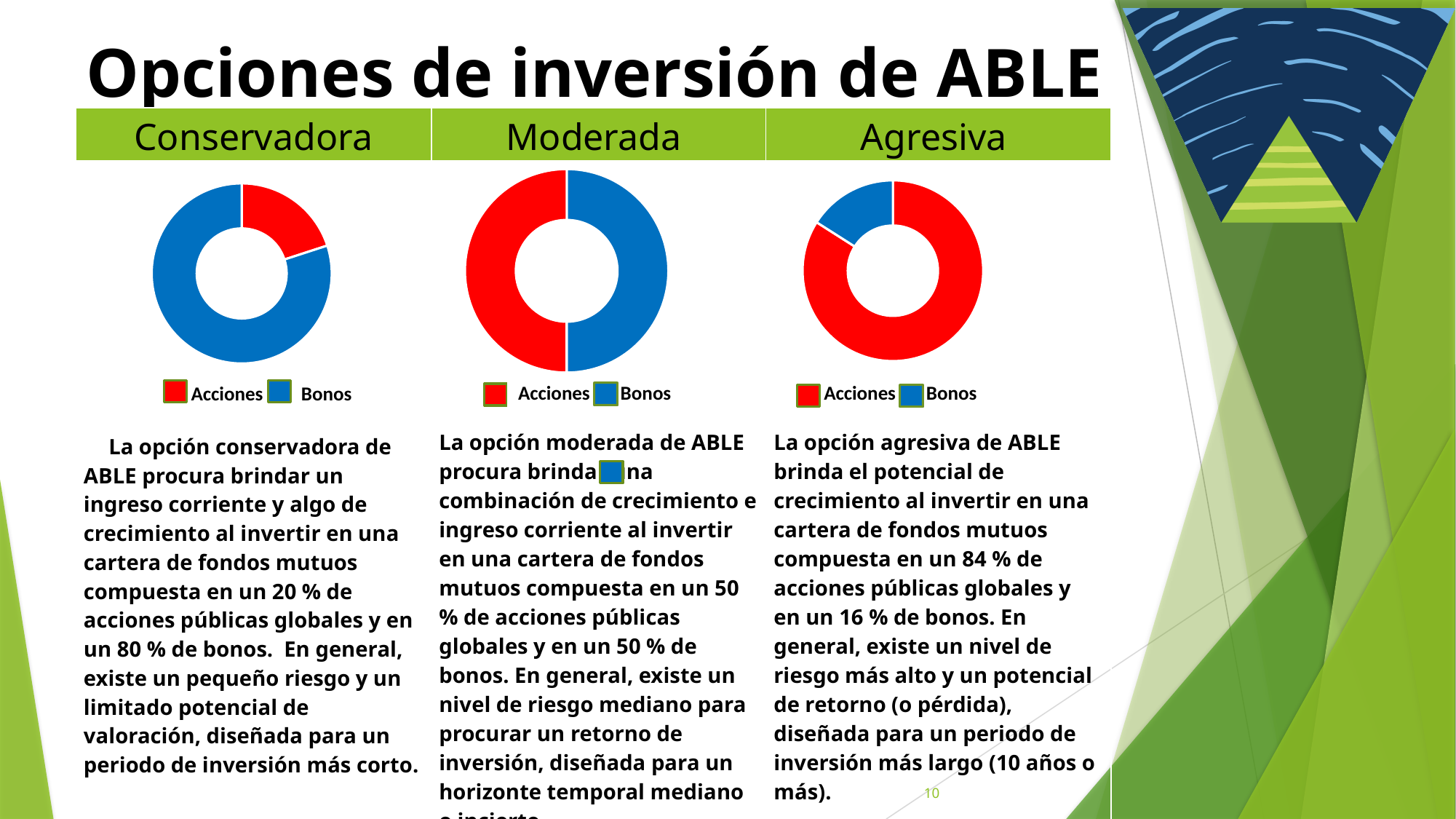
What kind of chart is used under the Conservadora heading? Pie (donut) chart In the Agresiva chart, what share of the pie is Bonos? 16 % How many donut charts are shown on the slide? 3 In the Agresiva chart, which slice is larger, Acciones or Bonos? Acciones What colour represents Bonos in the three charts? Blue In the Moderada chart, what share of the pie is Acciones? 50 % In the Conservadora chart, what share of the pie is Bonos? 80 % In the Conservadora chart, which slice is larger, Acciones or Bonos? Bonos How many series does the legend list for the Moderada chart? 2 How many slices does the Agresiva chart have? 2